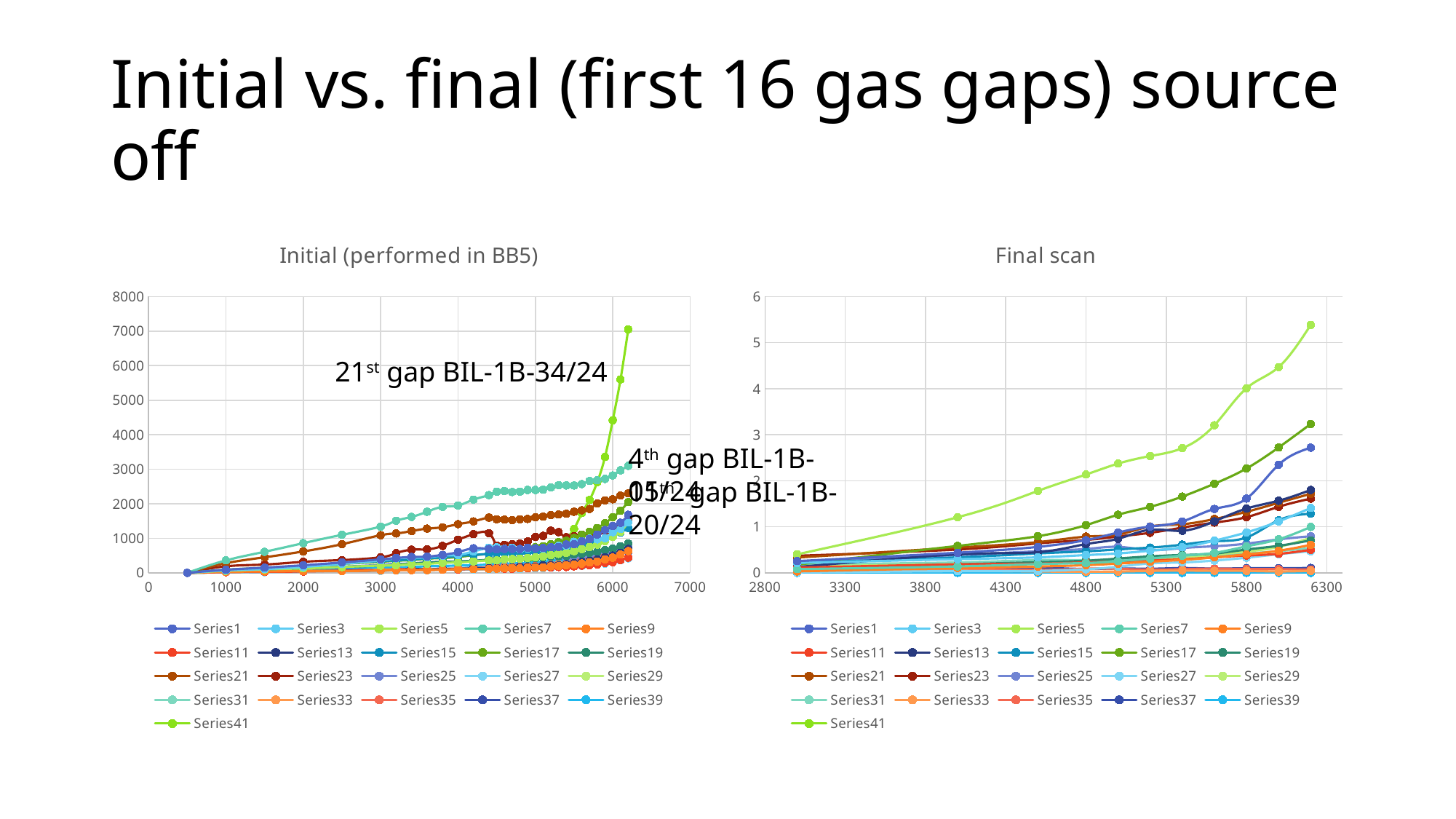
What is the title of the left chart? Initial (performed in BB5) How many series does the legend of the 'Initial (performed in BB5)' chart list? 21 What is the highest tick value on the y-axis of the 'Final scan' chart? 6 On the 'Final scan' chart, is the highest value reached by any series greater or less than 5? greater On the 'Final scan' chart, do the series generally rise or fall as the x-axis value increases? rise What kind of chart is the 'Initial (performed in BB5)' chart? line chart On the 'Initial (performed in BB5)' chart, is the highest value reached by Series41 greater or less than 6000? greater How many series does the legend of the 'Final scan' chart list? 21 On the 'Initial (performed in BB5)' chart, does Series41 rise or fall as the x-axis value increases? rise On the 'Initial (performed in BB5)' chart, which series reaches the highest value? Series41 What kind of chart is the 'Final scan' chart? line chart